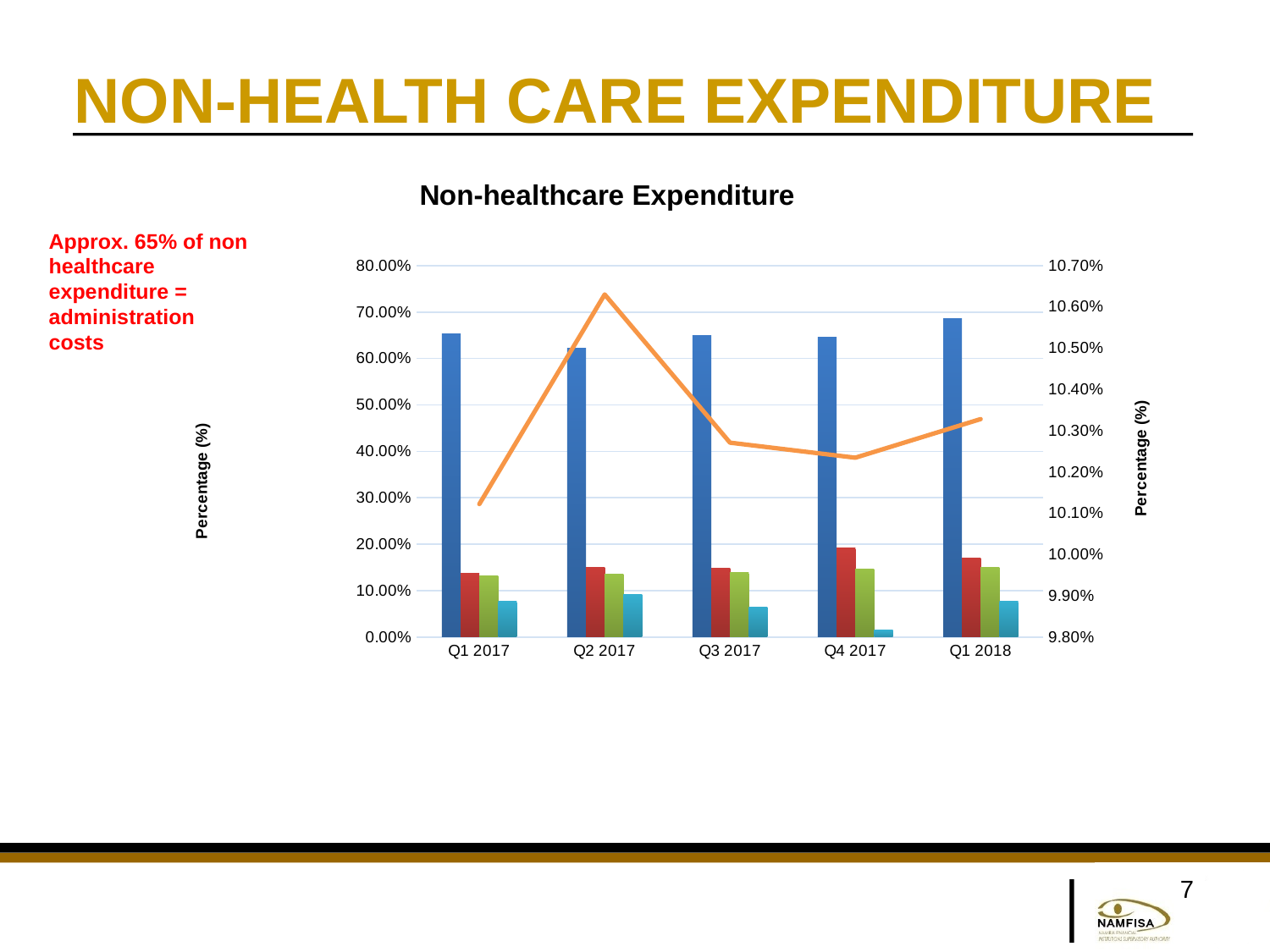
What is the title of the chart? Non-healthcare Expenditure In which quarter is the tallest bar the lowest compared with the other quarters? Q2 2017 Is the tallest bar for Q1 2018 greater or less than 70.00%? less In which quarter does the line series reach its highest point? Q2 2017 Which quarter has the tallest bar in the chart? Q1 2018 Is the tallest bar for Q2 2017 greater or less than 70.00%? less Is the tallest bar for Q1 2017 greater or less than 60.00%? greater How many quarters are shown on the x axis of the chart? 5 What label is shown on the left vertical axis of the chart? Percentage (%) Does the line series rise or fall from Q2 2017 to Q3 2017? fall In which quarter does the line series reach its lowest point? Q1 2017 What kind of chart is shown on the slide? A bar chart combined with a line